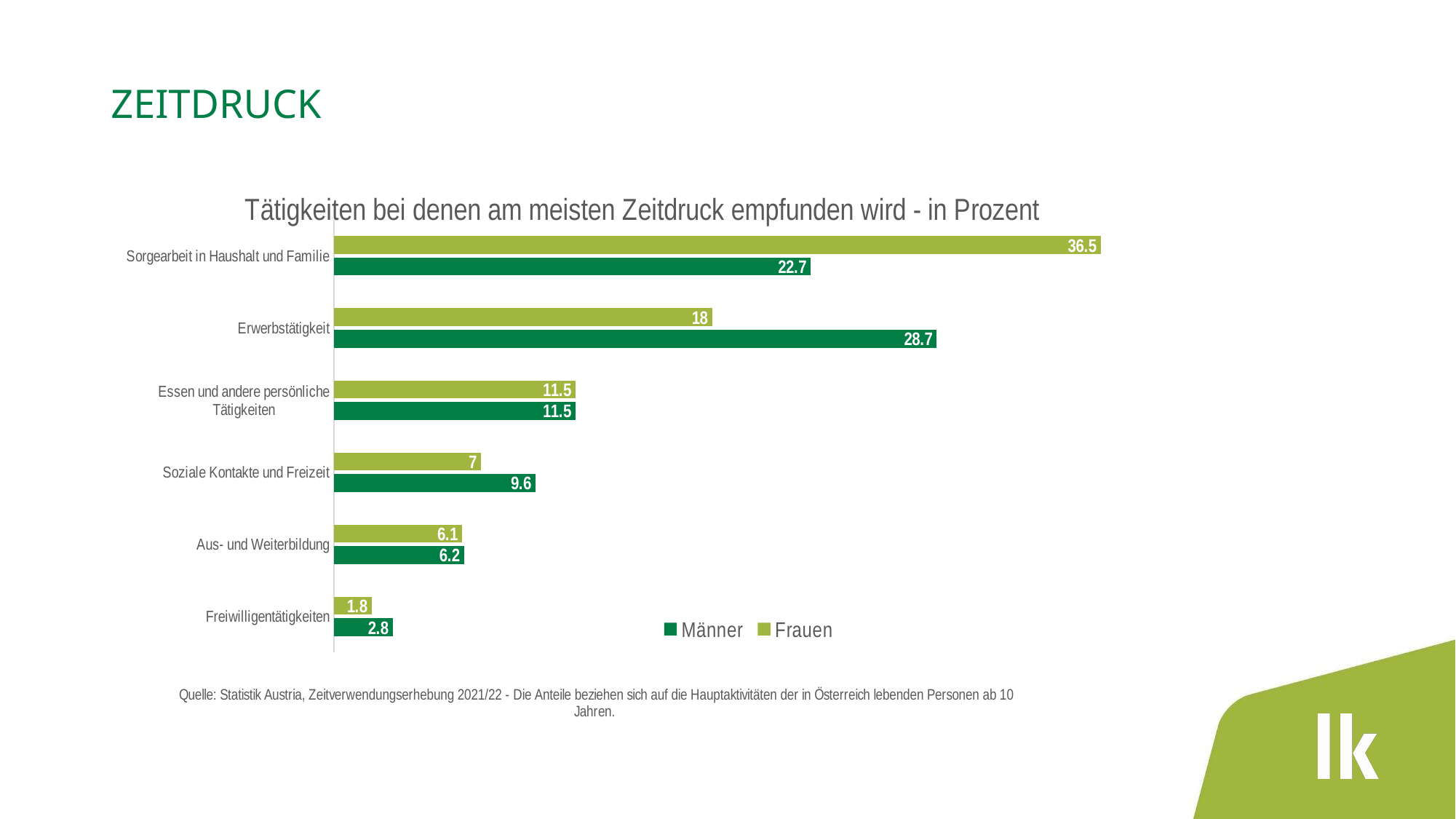
What is the difference between the Männer and Frauen values for Erwerbstätigkeit? 10.7 How many series does the legend list? 2 What is the difference between the Frauen and Männer values for Sorgearbeit in Haushalt und Familie? 13.8 Which category has the lowest value for Männer? Freiwilligentätigkeiten Which category has the highest value for Frauen? Sorgearbeit in Haushalt und Familie How many categories are shown in the chart? 6 What is the value for Frauen for Sorgearbeit in Haushalt und Familie? 36.5 What is the value for Männer for Erwerbstätigkeit? 28.7 What is the title of the chart? Tätigkeiten bei denen am meisten Zeitdruck empfunden wird - in Prozent What is the value for Männer for Soziale Kontakte und Freizeit? 9.6 For Erwerbstätigkeit, which is larger: the value for Männer or for Frauen? Männer What kind of chart is shown on the slide? Bar chart